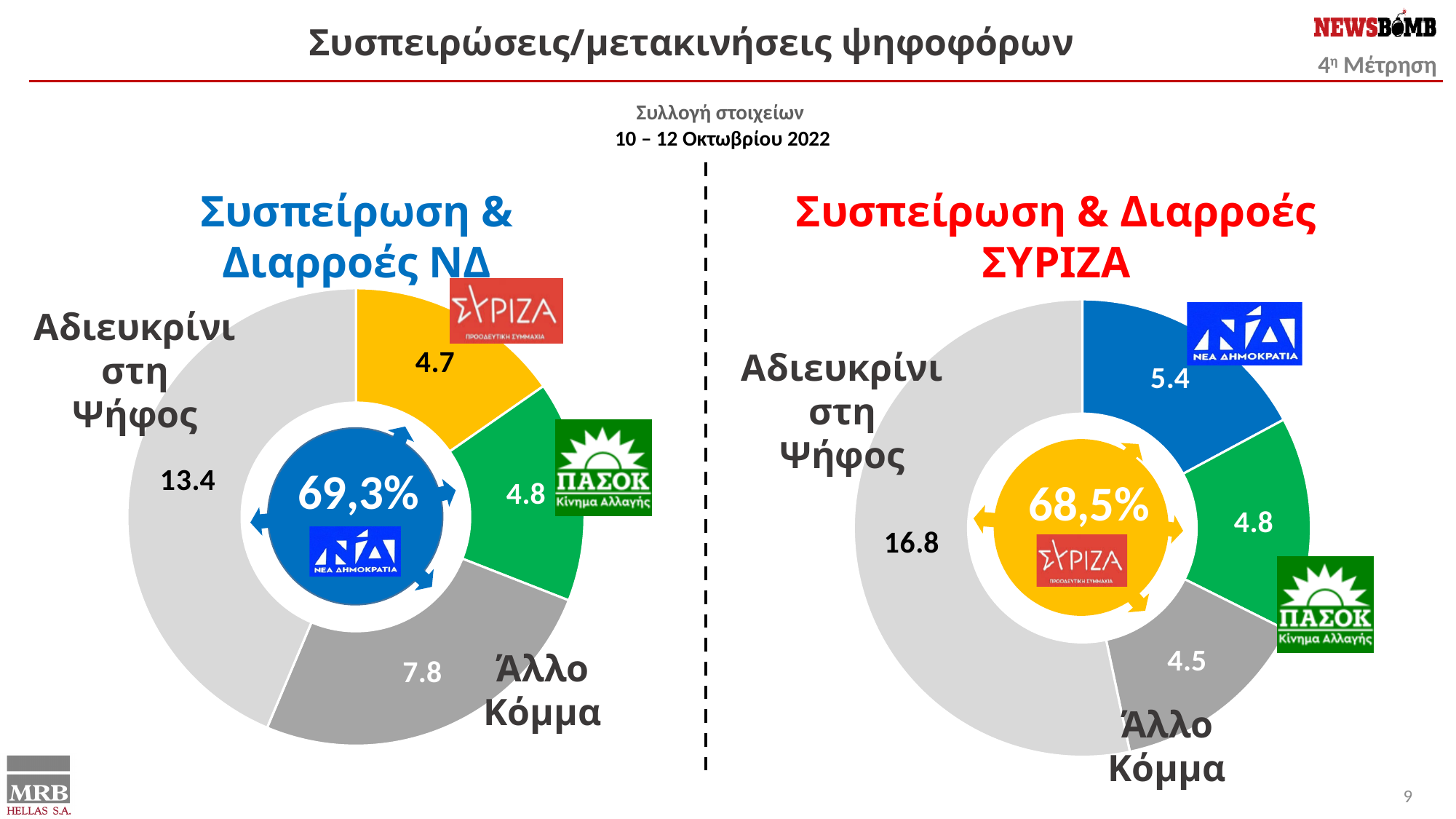
In the left chart (Συσπείρωση & Διαρροές ΝΔ), what percentage is printed in the centre of the donut? 69,3% What is the title of the right chart? Συσπείρωση & Διαρροές ΣΥΡΙΖΑ In the left chart (Συσπείρωση & Διαρροές ΝΔ), what is the difference between the Αδιευκρίνιστη Ψήφος value and the Άλλο Κόμμα value? 5.6 In the left chart (Συσπείρωση & Διαρροές ΝΔ), what value is shown for the ΣΥΡΙΖΑ slice? 4.7 In the right chart (Συσπείρωση & Διαρροές ΣΥΡΙΖΑ), what percentage is printed in the centre of the donut? 68,5% How many labelled slices does the left chart (Συσπείρωση & Διαρροές ΝΔ) have, excluding the centre value? 4 In the right chart (Συσπείρωση & Διαρροές ΣΥΡΙΖΑ), which labelled slice has the smallest value? Άλλο Κόμμα In the right chart (Συσπείρωση & Διαρροές ΣΥΡΙΖΑ), what value is shown for the ΝΔ slice? 5.4 What kind of chart is used on this slide? Donut (pie) chart In the left chart (Συσπείρωση & Διαρροές ΝΔ), what value is shown for Αδιευκρίνιστη Ψήφος? 13.4 In the right chart (Συσπείρωση & Διαρροές ΣΥΡΙΖΑ), which labelled slice has the largest value? Αδιευκρίνιστη Ψήφος Which is larger: the Άλλο Κόμμα value in the left chart (ΝΔ) or the Άλλο Κόμμα value in the right chart (ΣΥΡΙΖΑ)? Left chart (ΝΔ), 7.8